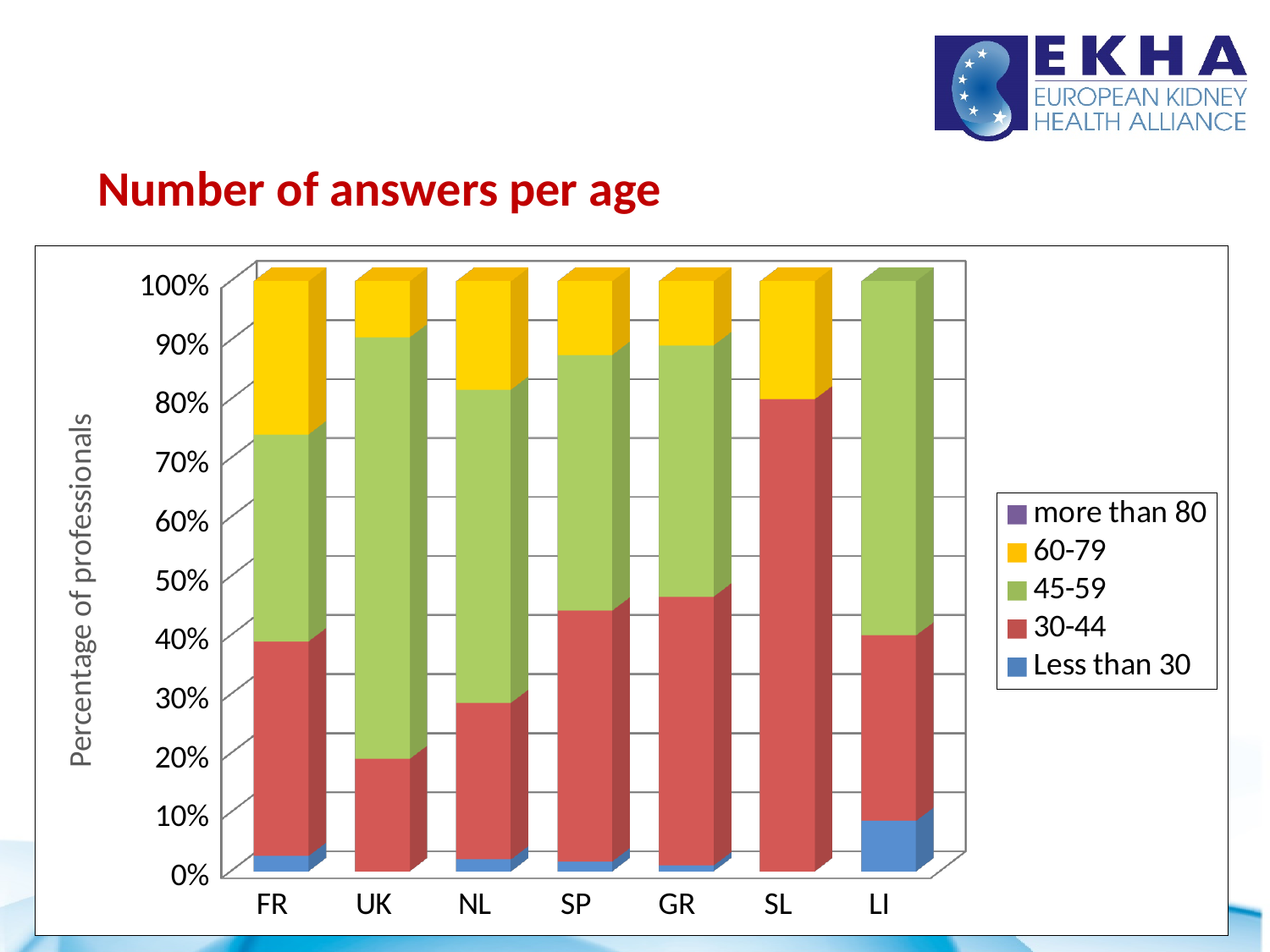
Which country has the largest share of professionals in the 45-59 age group? UK What is the label of the vertical axis? Percentage of professionals What kind of chart is shown on the slide? Stacked bar chart How many age groups does the legend list? 5 Is the share of the 30-44 age group for NL greater or less than 20%? greater What is the title of the chart? Number of answers per age Is the share of the 30-44 age group for SL greater or less than 70%? greater Which country has the largest share of professionals in the 30-44 age group? SL Which has a larger share of the 30-44 age group, SL or FR? SL Is the share of the 60-79 age group for FR greater or less than 20%? greater How many countries are shown on the x axis of the chart? 7